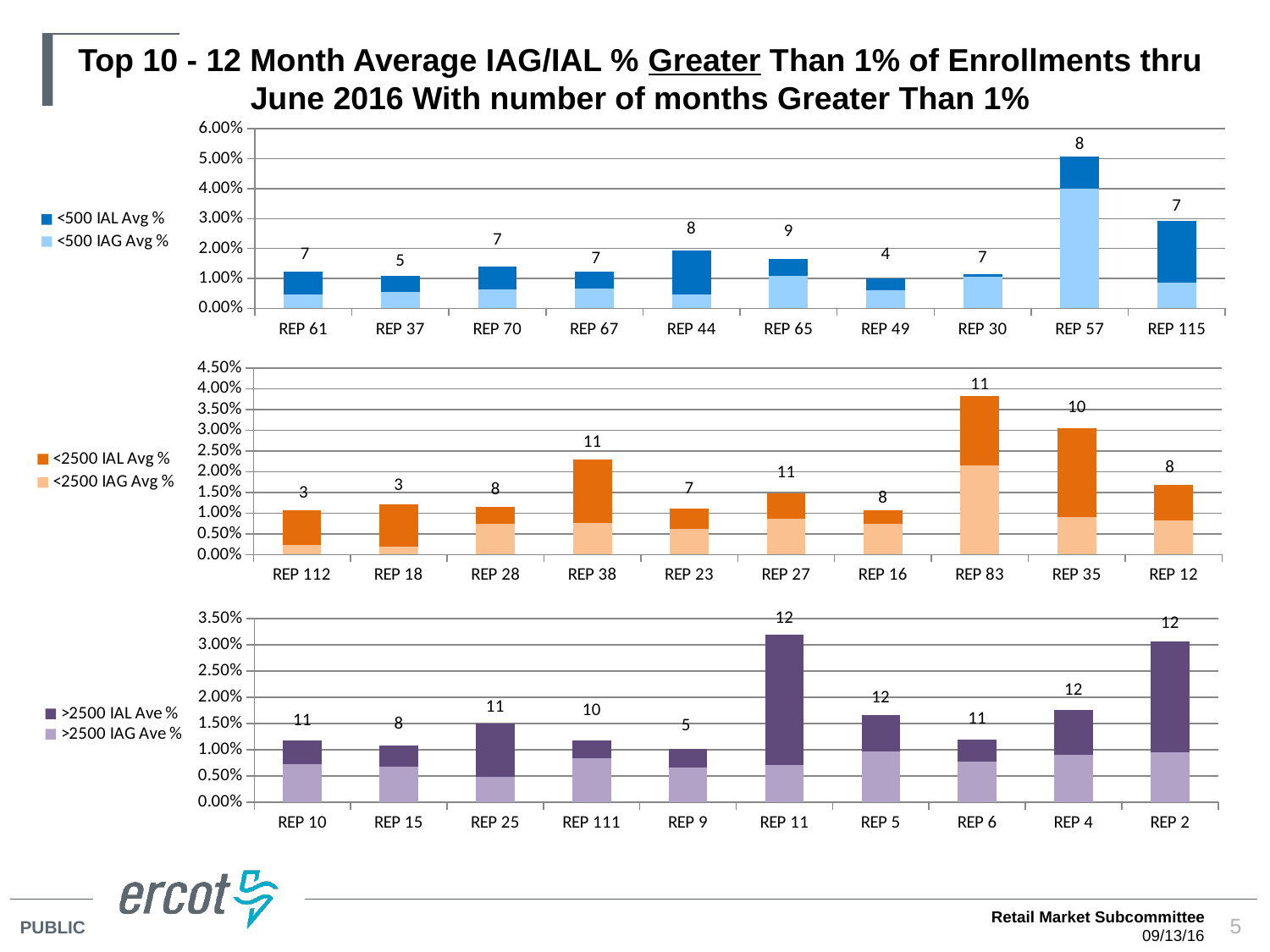
In the middle chart, which REP has the highest total bar? REP 83 In the bottom chart, is the total value for REP 11 greater or less than 3.00%? greater How many REP categories are shown in the bottom chart? 10 In the top chart, what number of months is printed above the bar for REP 65? 9 In the middle chart, what number of months is printed above the bar for REP 83? 11 In the middle chart, which has the larger total bar, REP 38 or REP 12? REP 38 In the top chart, which REP has the highest total bar? REP 57 In the top chart, is the total value for REP 57 greater or less than 4.00%? greater What type of chart is the top chart on the slide? Stacked bar chart In the bottom chart, what number of months is printed above the bar for REP 9? 5 How many series does the legend of the middle chart list? 2 In the middle chart, is the total value for REP 83 greater or less than 3.50%? greater